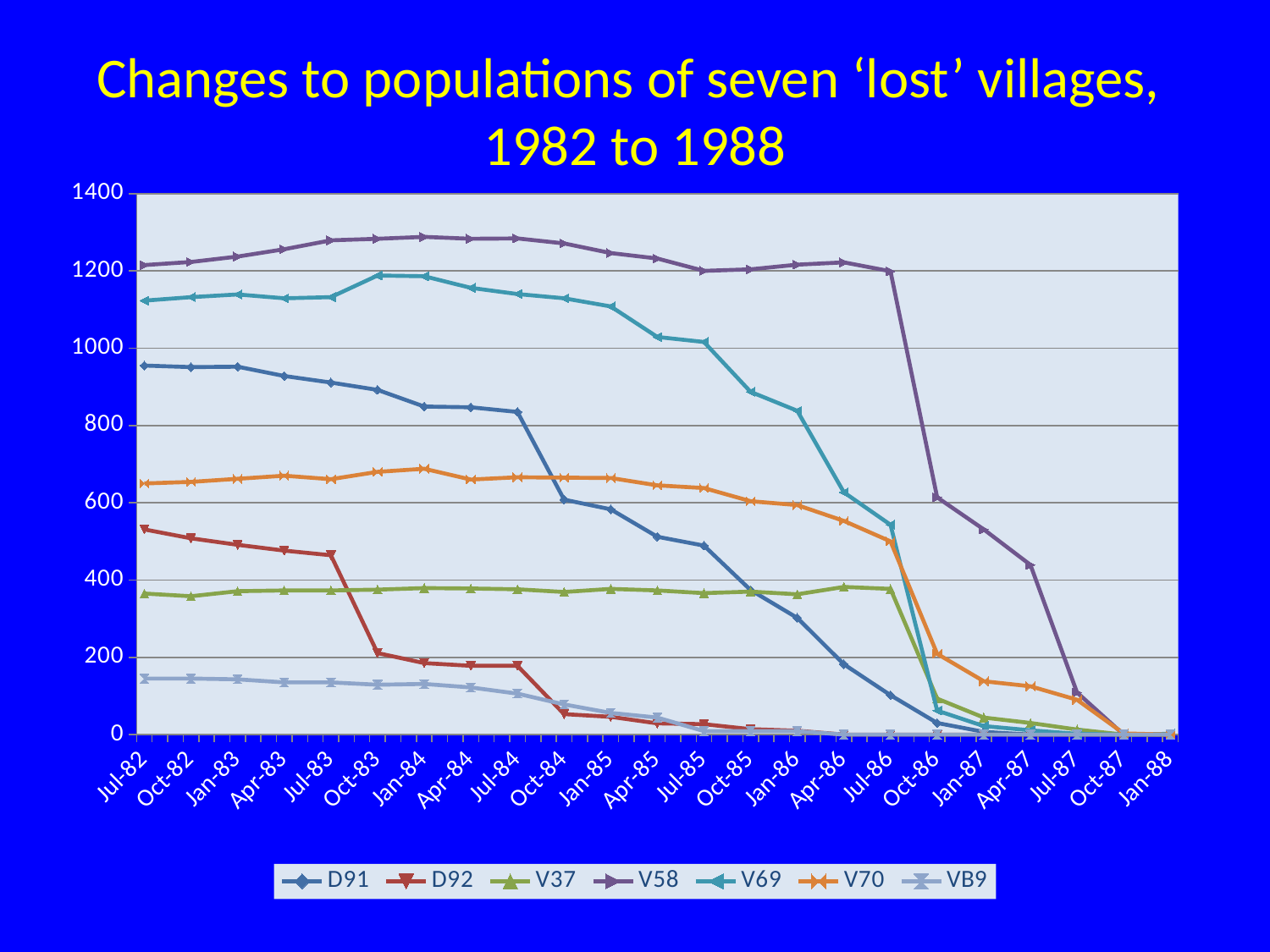
Which series has the lowest value at Jul-82? VB9 At Jul-82, which is larger, the value for D91 or the value for V70? D91 Is the value for V69 at Jul-82 greater or less than 1000? greater How many series does the legend list? 7 Which series has the highest value at Jul-82? V58 What is the title of the chart? Changes to populations of seven 'lost' villages, 1982 to 1988 How many dates are labelled along the x axis? 23 What kind of chart is shown on the slide? line chart Is the value for V58 at Jan-84 greater or less than 1200? greater Is the value for VB9 at Jul-82 greater or less than 200? less Do the values for D91 rise or fall from Jul-82 to Jan-88? fall